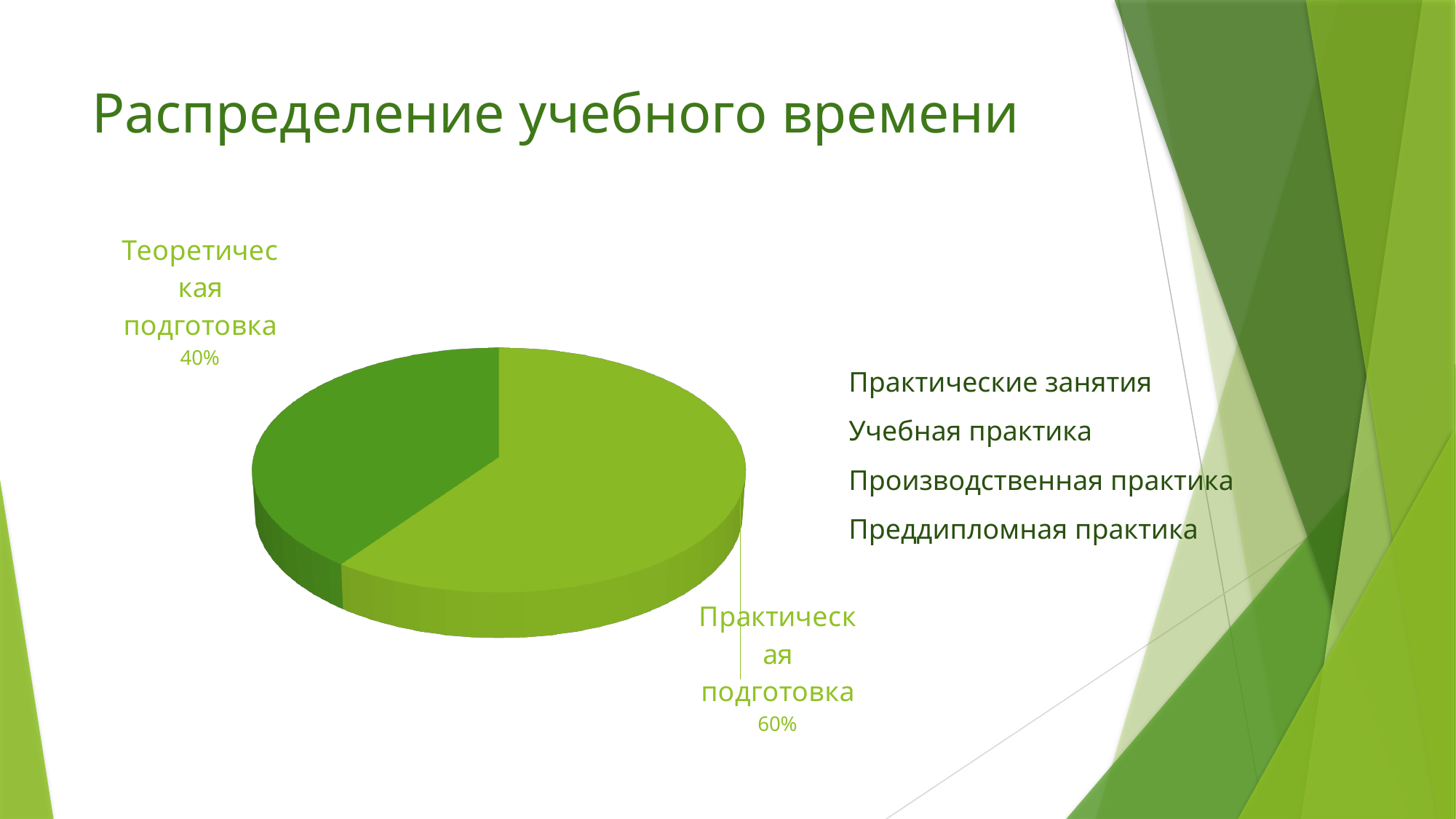
Which slice of the pie is the largest? Практическая подготовка Which slice of the pie is the smallest? Теоретическая подготовка Which is larger, Теоретическая подготовка or Практическая подготовка? Практическая подготовка What kind of chart is shown on the slide? Pie chart What is the difference in percentage points between Практическая подготовка and Теоретическая подготовка? 20% How many slices does the pie chart have? 2 What is the total of the two pie slice percentages? 100% What share of the pie does Теоретическая подготовка represent? 40% What is the title of the slide containing the chart? Распределение учебного времени Is the share for Теоретическая подготовка greater or less than 50%? less What share of the pie does Практическая подготовка represent? 60%